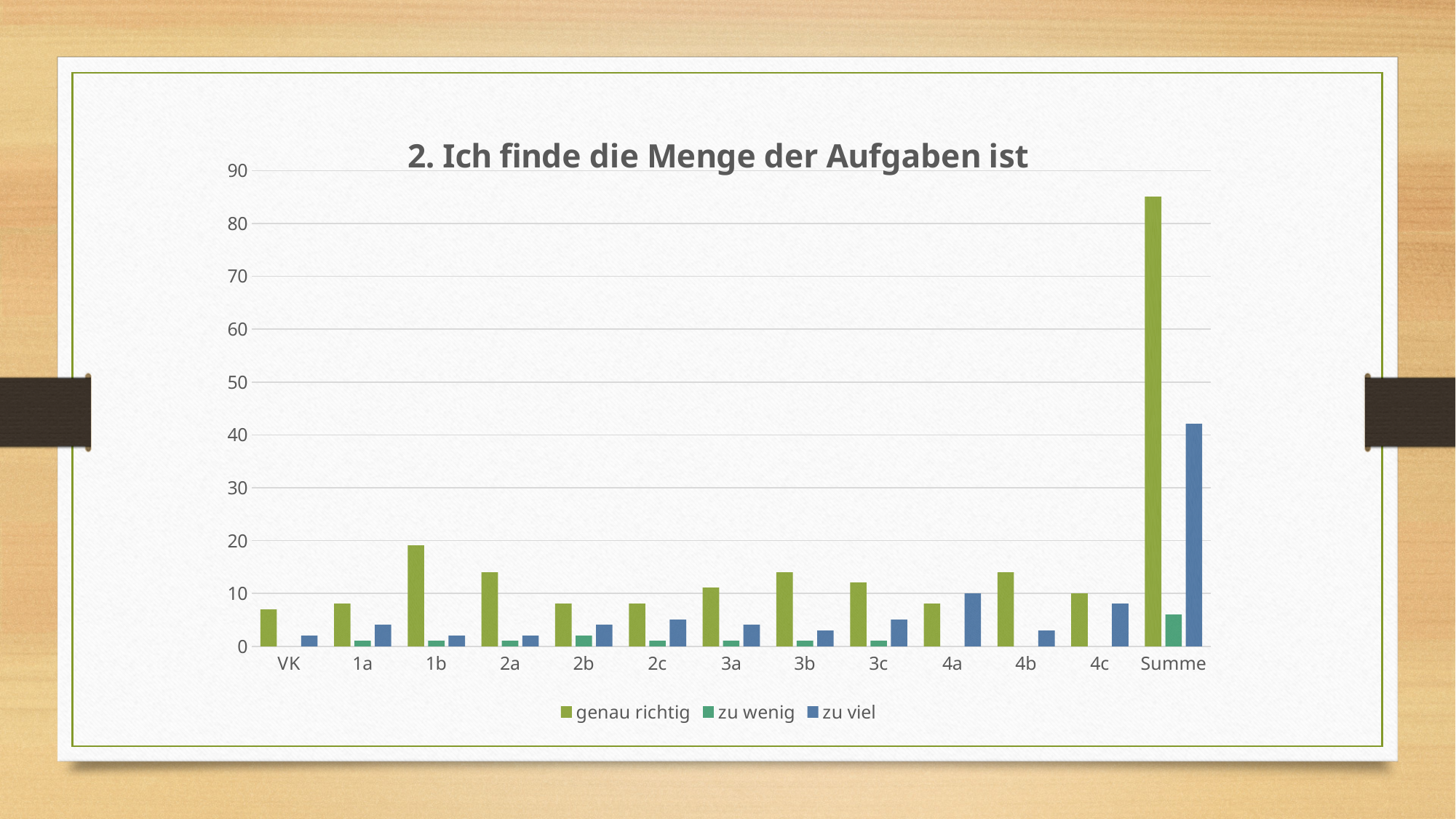
Is the value for 'zu viel' in the category Summe greater or less than 50? less What kind of chart is shown on the slide? bar chart Which category has the highest value for the series 'zu viel'? Summe For the category Summe, which series has the larger value: 'genau richtig' or 'zu viel'? genau richtig Which category has the highest value for the series 'genau richtig'? Summe How many series does the legend list? 3 What is the title of the chart? 2. Ich finde die Menge der Aufgaben ist Is the value for 'genau richtig' in the category Summe greater or less than 80? greater Which series is shown in blue in the legend? zu viel How many categories are shown on the x axis? 13 Is the value for 'genau richtig' in the category 1b greater or less than 10? greater Which category has the larger value for 'genau richtig': 1b or 2a? 1b